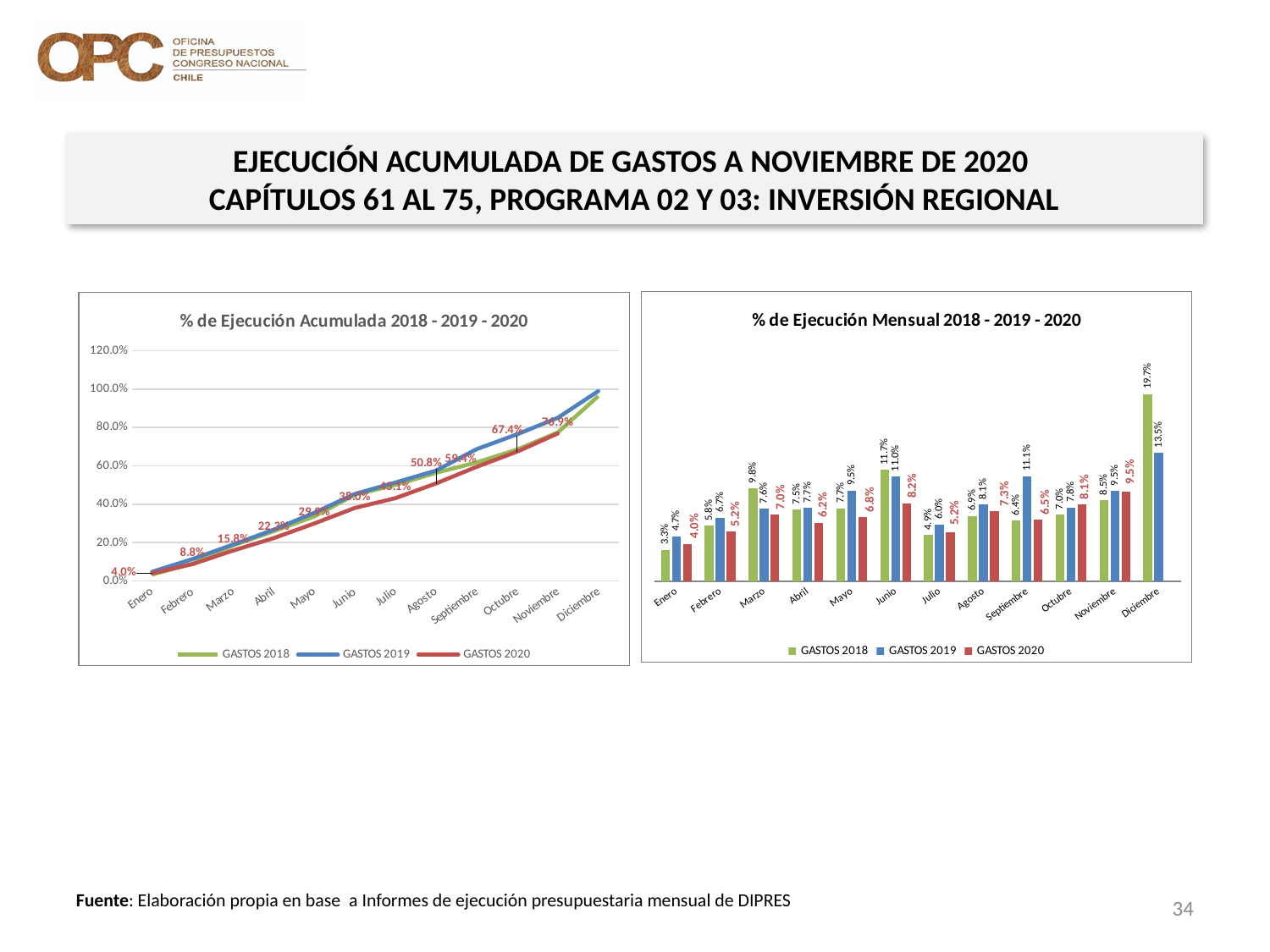
In the '% de Ejecución Mensual 2018 - 2019 - 2020' chart, what is the value for GASTOS 2018 in Diciembre? 19.7% In the '% de Ejecución Acumulada 2018 - 2019 - 2020' chart, how many months are shown on the x axis? 12 In the '% de Ejecución Acumulada 2018 - 2019 - 2020' chart, is the value for GASTOS 2019 in Diciembre greater or less than 80.0%? greater What kind of chart is the right-hand chart, '% de Ejecución Mensual 2018 - 2019 - 2020'? Bar chart In the '% de Ejecución Mensual 2018 - 2019 - 2020' chart, what is the value for GASTOS 2020 in Junio? 8.2% In the '% de Ejecución Mensual 2018 - 2019 - 2020' chart, how many series does the legend list? 3 In the '% de Ejecución Acumulada 2018 - 2019 - 2020' chart, what is the value for GASTOS 2020 in Noviembre? 76.9% In the '% de Ejecución Mensual 2018 - 2019 - 2020' chart, which month has the highest value for GASTOS 2019? Diciembre In the '% de Ejecución Mensual 2018 - 2019 - 2020' chart, which is larger in Septiembre: GASTOS 2018 or GASTOS 2019? GASTOS 2019 In the '% de Ejecución Mensual 2018 - 2019 - 2020' chart, which month has the lowest value for GASTOS 2018? Enero In the '% de Ejecución Mensual 2018 - 2019 - 2020' chart, what is the difference between GASTOS 2018 and GASTOS 2019 in Diciembre? 6.2 percentage points What kind of chart is the left-hand chart, '% de Ejecución Acumulada 2018 - 2019 - 2020'? Line chart